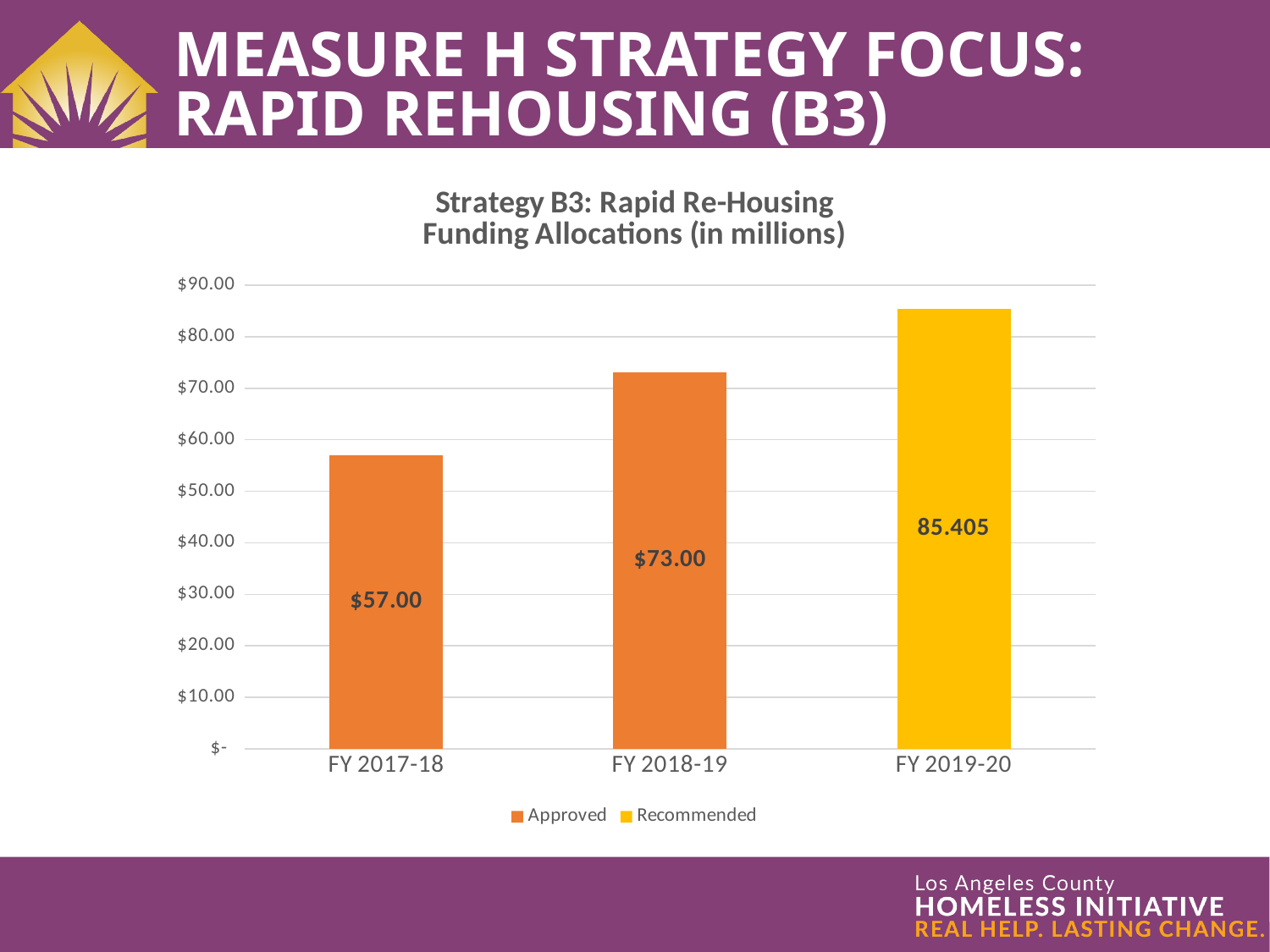
Which fiscal year has the lowest funding allocation? FY 2017-18 How many series does the legend list? 2 How many fiscal years are shown on the chart? 3 What is the funding allocation for FY 2018-19? $73.00 What is the data label shown on the FY 2019-20 bar? 85.405 What is the funding allocation for FY 2017-18? $57.00 Which fiscal year has the highest funding allocation? FY 2019-20 Which is larger, the allocation for FY 2018-19 or FY 2017-18? FY 2018-19 What is the difference between the FY 2018-19 and FY 2017-18 allocations? $16.00 Do the funding allocations rise or fall from FY 2017-18 to FY 2019-20? Rise Is the value for FY 2019-20 greater or less than $80.00? greater What kind of chart is shown on the slide? Bar chart